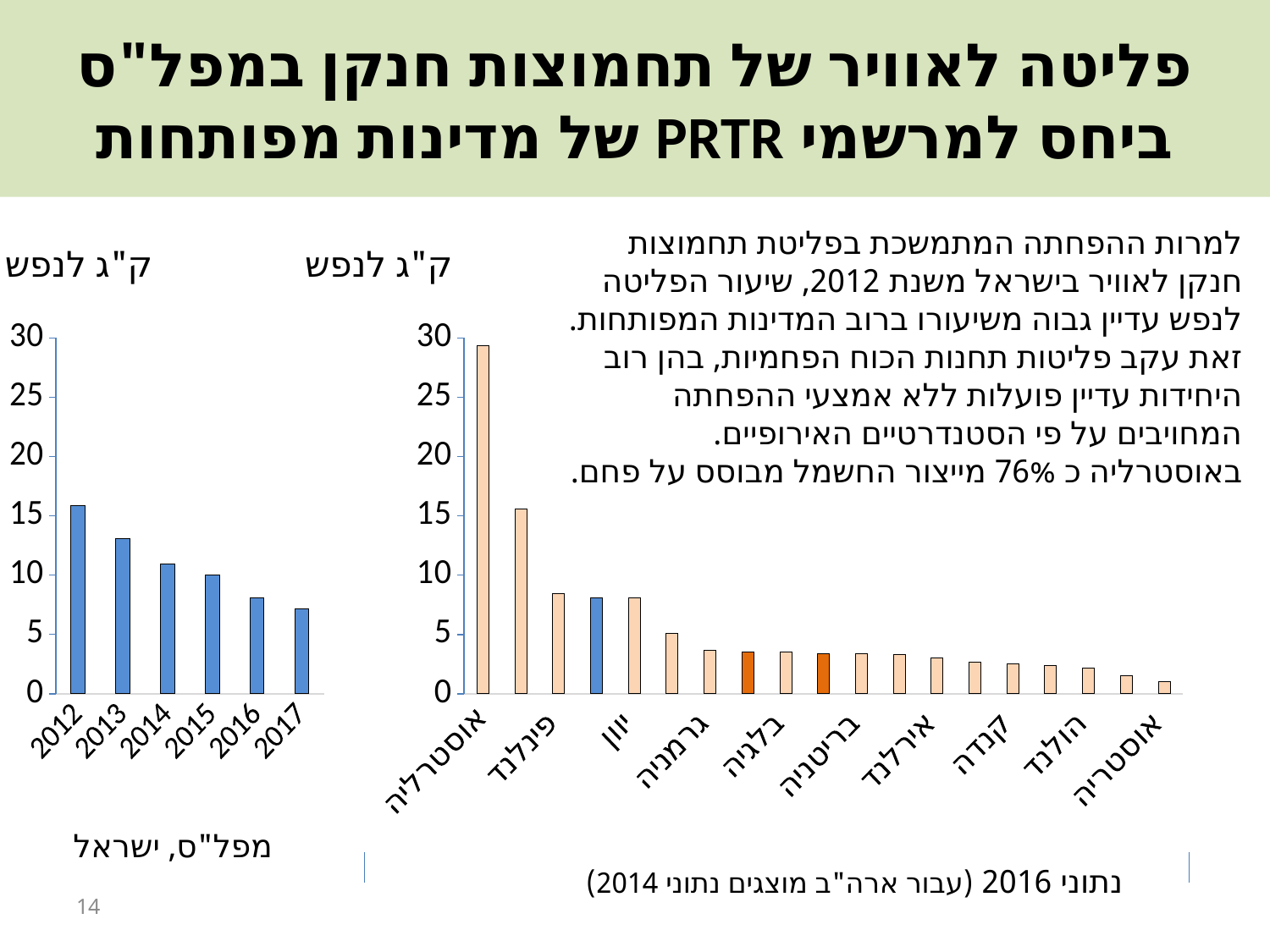
In the left chart (מפל"ס, ישראל), which year has the lowest value? 2017 What kind of chart is the left chart titled "מפל"ס, ישראל"? bar chart In the left chart (מפל"ס, ישראל), is the value for 2017 greater or less than 10? less In the right chart (countries), which is larger, the value for אוסטרליה or the value for אוסטריה? אוסטרליה In the right chart (countries), which country has the lowest value? אוסטריה In the right chart (countries), is the value for אוסטרליה greater or less than 25? greater In the left chart (מפל"ס, ישראל), which year has the highest value? 2012 In the left chart (מפל"ס, ישראל), is the value for 2013 greater or less than 10? greater In the left chart (מפל"ס, ישראל), how many years are shown on the x axis? 6 What is the y-axis unit label shown above both charts? ק"ג לנפש In the right chart (countries), which country has the highest value? אוסטרליה In the left chart (מפל"ס, ישראל), do the values rise or fall from 2012 to 2017? fall